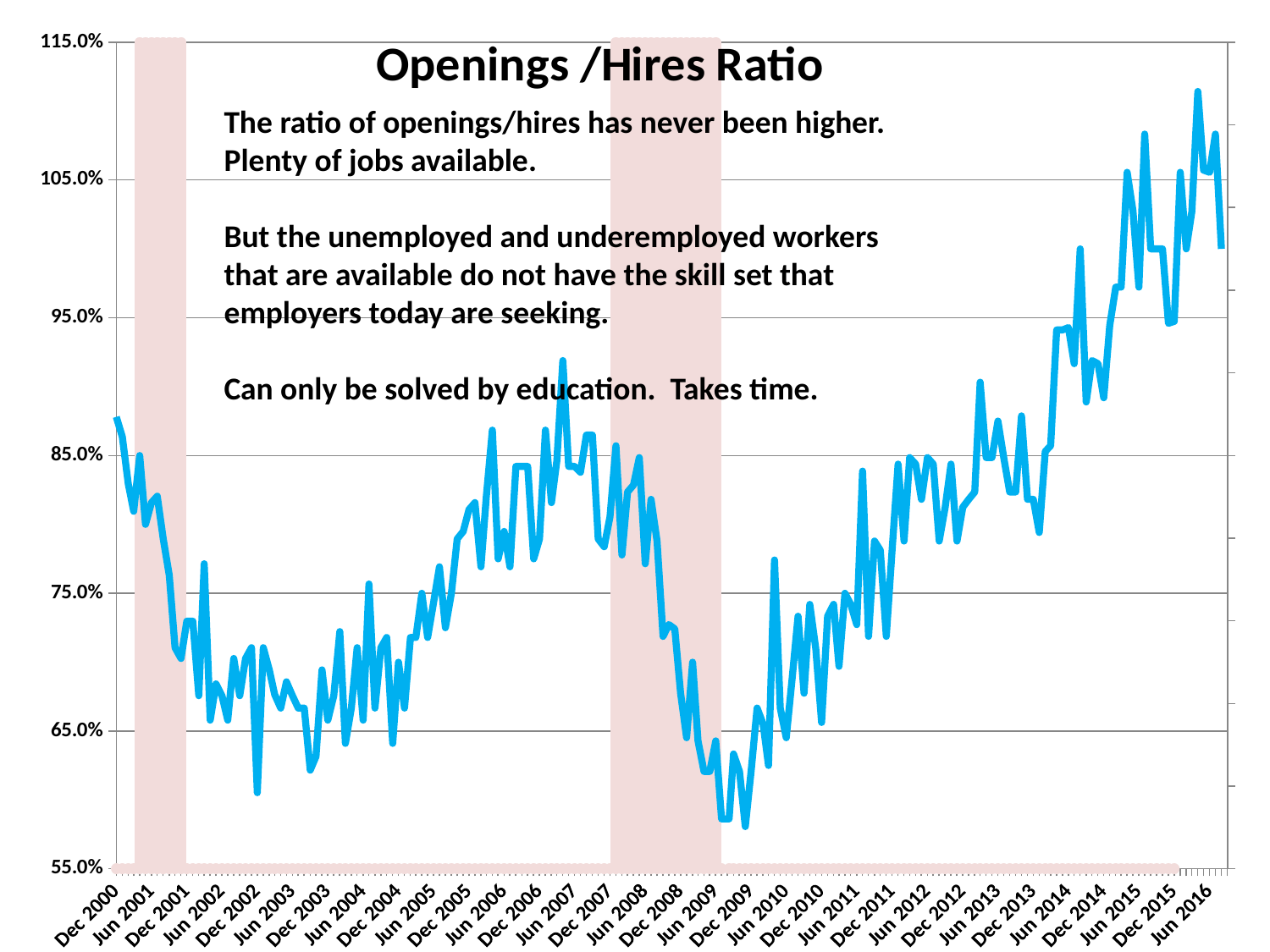
Does the line generally rise or fall between Jun 2009 and Jun 2016? rise Is the value at Dec 2000 greater or less than 85.0%? greater Does the line generally rise or fall between Dec 2007 and Jun 2009? fall In which year does the line reach its lowest point? 2009 In which year does the line reach its highest point? 2016 Is the value at Jun 2016 greater or less than 95.0%? greater Is the value at Dec 2002 greater or less than 75.0%? less What kind of chart is shown on the slide? line chart What is the title of the chart? Openings /Hires Ratio How many date labels are shown along the x axis of the chart? 32